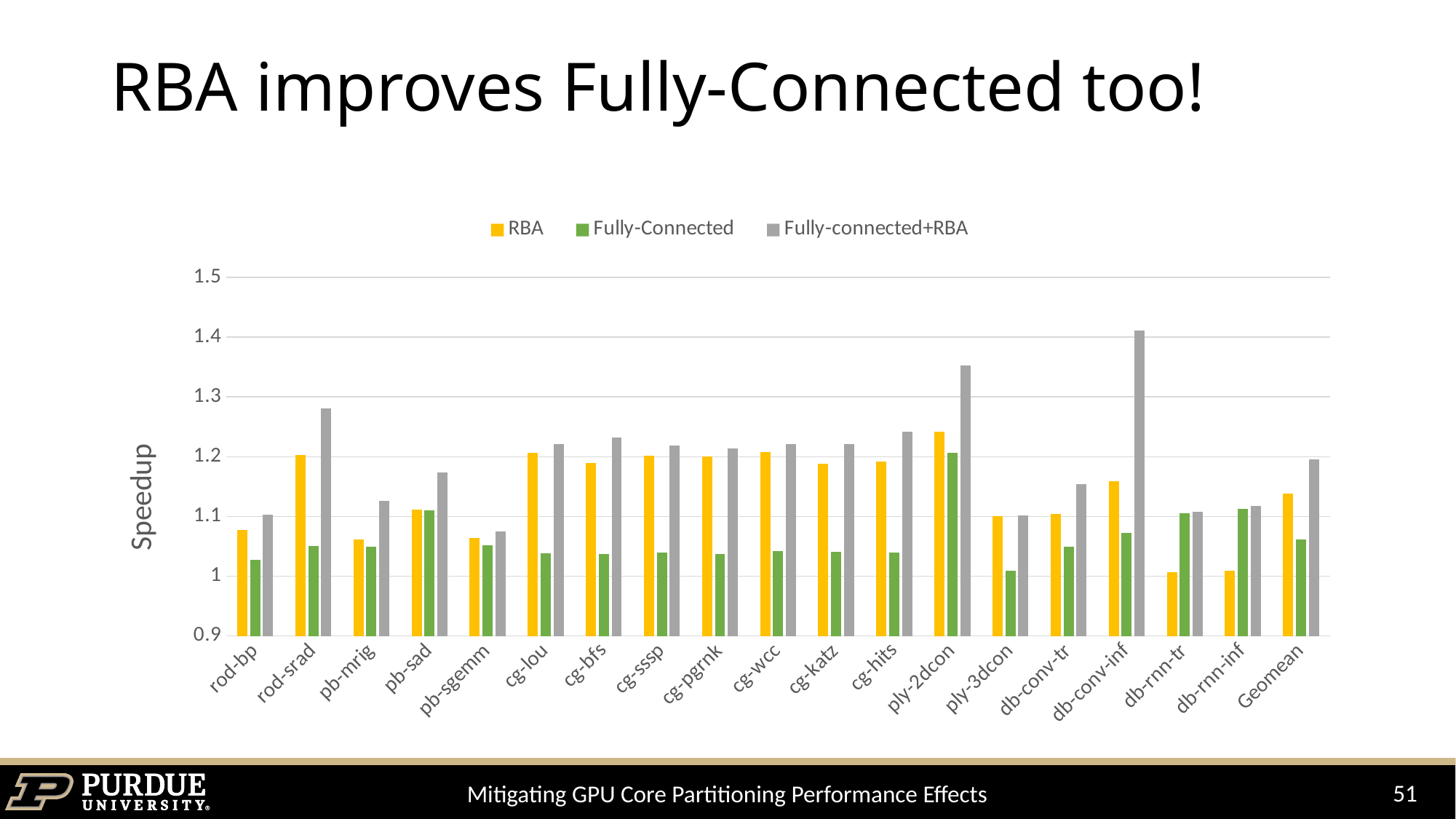
Is the Fully-Connected value for Geomean greater or less than 1.1? less Is the Fully-connected+RBA value for db-conv-inf greater or less than 1.4? greater How many series does the legend list? 3 What kind of chart is shown on the slide? bar chart Is the Fully-connected+RBA value for ply-2dcon greater or less than 1.3? greater How many categories are shown along the x axis? 19 What is the label of the y axis? Speedup For db-rnn-tr, which is larger: the RBA value or the Fully-Connected value? Fully-Connected Which category has the highest Fully-connected+RBA value? db-conv-inf Which category has the highest RBA value? ply-2dcon For Geomean, which is larger: the RBA value or the Fully-Connected value? RBA